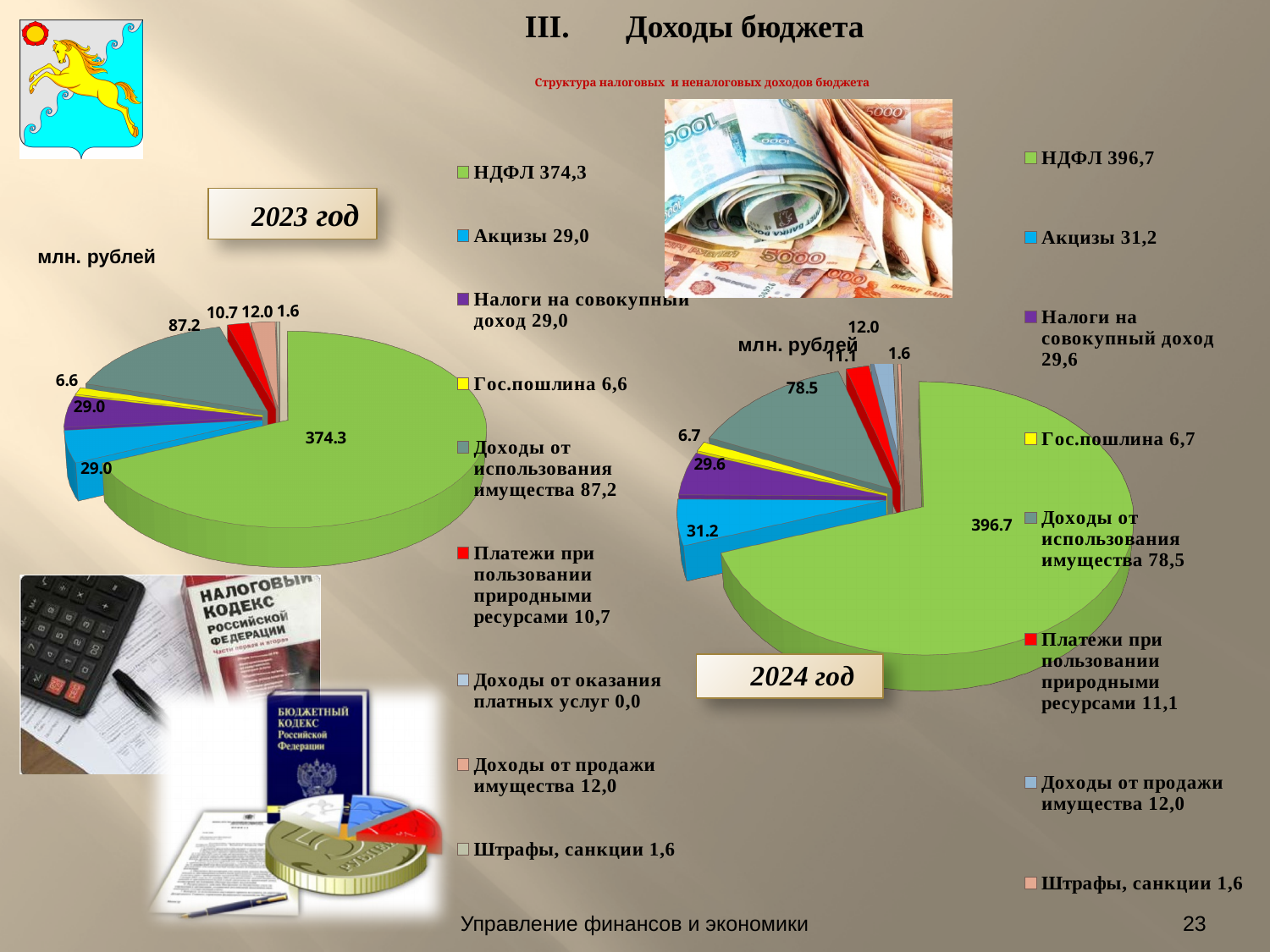
What kind of chart is the 2023 год chart? pie chart On the 2023 год chart, what is the difference between Доходы от использования имущества and Акцизы? 58.2 How many entries does the legend of the 2023 год chart list? 9 On the 2023 год chart, what is the value for НДФЛ? 374.3 On the 2024 год chart, what is the value for Акцизы? 31.2 What is the difference between НДФЛ in the 2024 год chart and НДФЛ in the 2023 год chart? 22.4 On the 2024 год chart, what is the value for Доходы от использования имущества? 78.5 On the 2023 год chart, which category has the largest slice? НДФЛ How many entries does the legend of the 2024 год chart list? 8 Which is larger: Доходы от использования имущества in the 2023 год chart or in the 2024 год chart? 2023 год On the 2024 год chart, which category has the smallest value? Штрафы, санкции What unit is stated for the values on both pie charts? млн. рублей